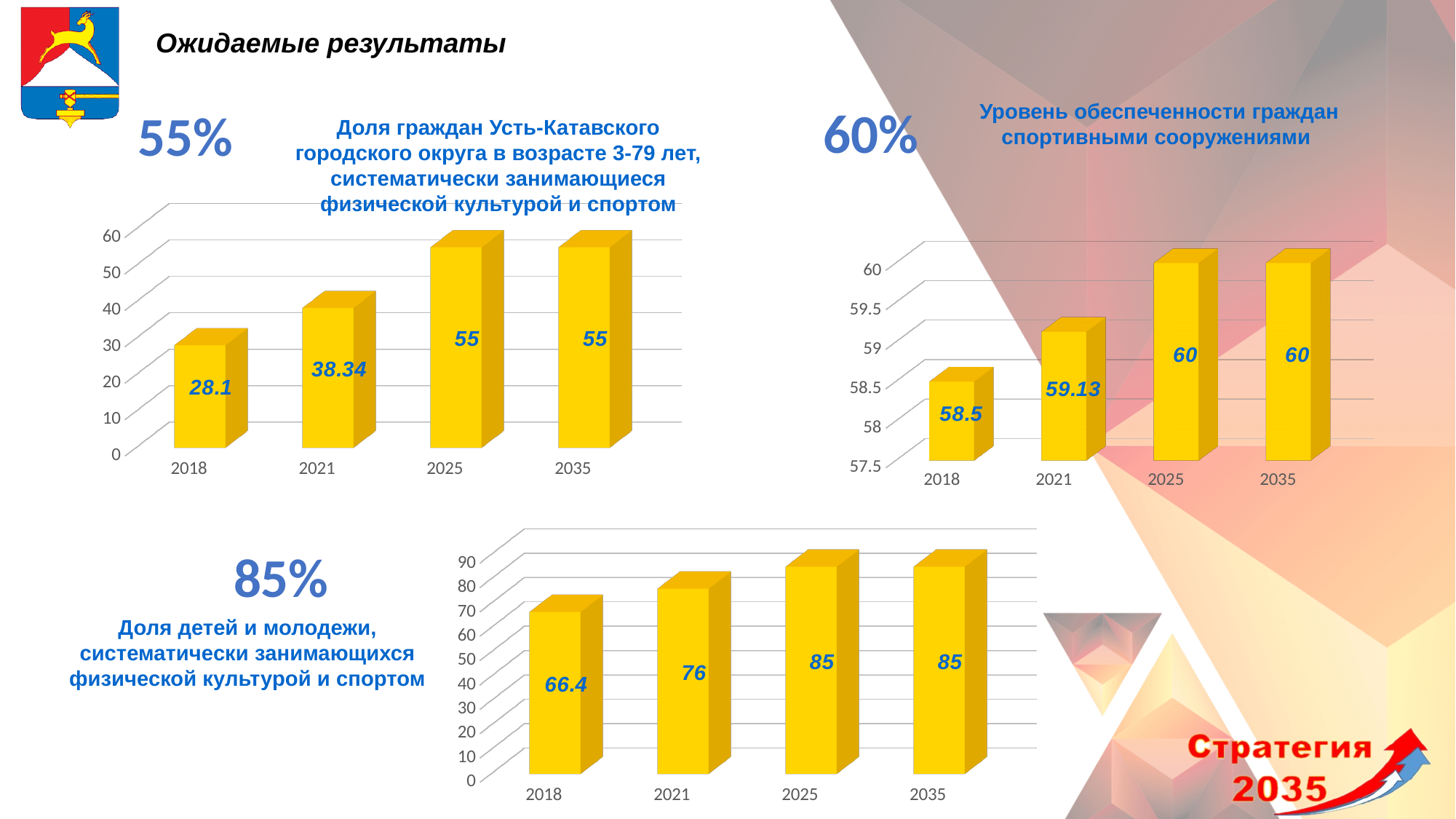
In the bottom chart (Доля детей и молодежи, систематически занимающихся физической культурой и спортом), what is the value for 2018? 66.4 In the bottom chart (Доля детей и молодежи, систематически занимающихся физической культурой и спортом), do the values rise or fall from 2018 to 2025? rise In the top-right chart (Уровень обеспеченности граждан спортивными сооружениями), what is the value for 2018? 58.5 In the top-right chart (Уровень обеспеченности граждан спортивными сооружениями), what is the value for 2021? 59.13 In the bottom chart (Доля детей и молодежи, систематически занимающихся физической культурой и спортом), what is the difference between the 2021 value and the 2018 value? 9.6 In the top-right chart (Уровень обеспеченности граждан спортивными сооружениями), how many years are shown on the x axis? 4 In the bottom chart (Доля детей и молодежи, систематически занимающихся физической культурой и спортом), is the value for 2021 larger or smaller than the value for 2025? smaller In the top-left chart (share of citizens aged 3-79 systematically engaged in physical culture and sport), what is the value for 2018? 28.1 In the top-left chart (share of citizens aged 3-79 systematically engaged in physical culture and sport), what is the value for 2021? 38.34 In the top-left chart (share of citizens aged 3-79 systematically engaged in physical culture and sport), which year has the lowest value? 2018 In the top-left chart (share of citizens aged 3-79 systematically engaged in physical culture and sport), what is the difference between the 2025 value and the 2018 value? 26.9 What kind of chart is the bottom chart (Доля детей и молодежи, систематически занимающихся физической культурой и спортом)? bar chart